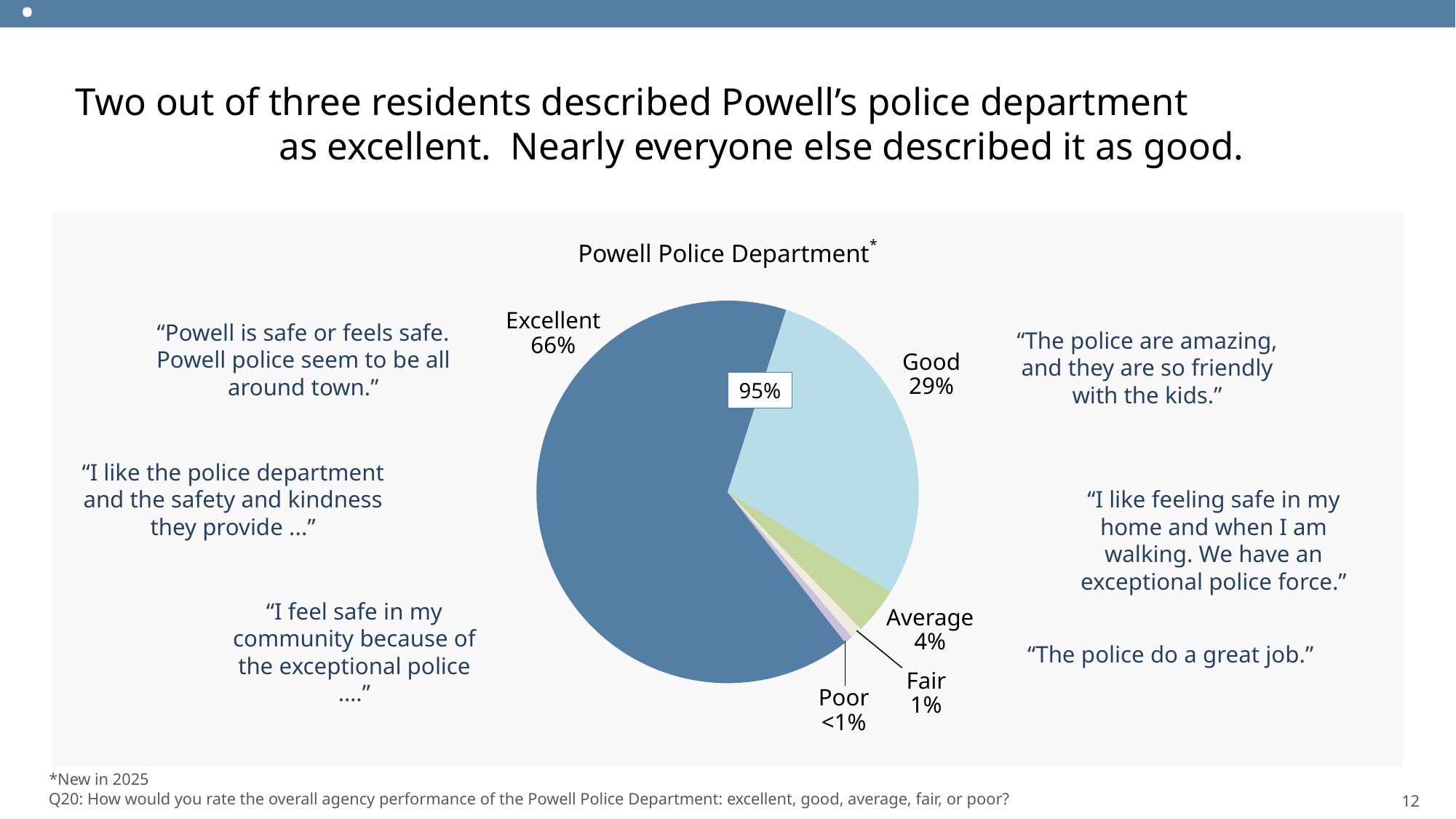
How many rating categories are shown in the pie chart? 5 What percentage of residents rated the police department as Excellent? 66% What is the difference in percentage points between the Excellent and Good slices? 37 What combined percentage is shown in the box inside the pie chart? 95% Which rating category has the largest slice of the pie? Excellent What is the title of the chart? Powell Police Department What percentage of residents rated the police department as Fair? 1% Which rating category has the smallest slice of the pie? Poor What type of chart is shown on the slide? pie chart What percentage of residents rated the police department as Good? 29% What value is shown for the Poor slice? <1% What percentage of residents rated the police department as Average? 4%